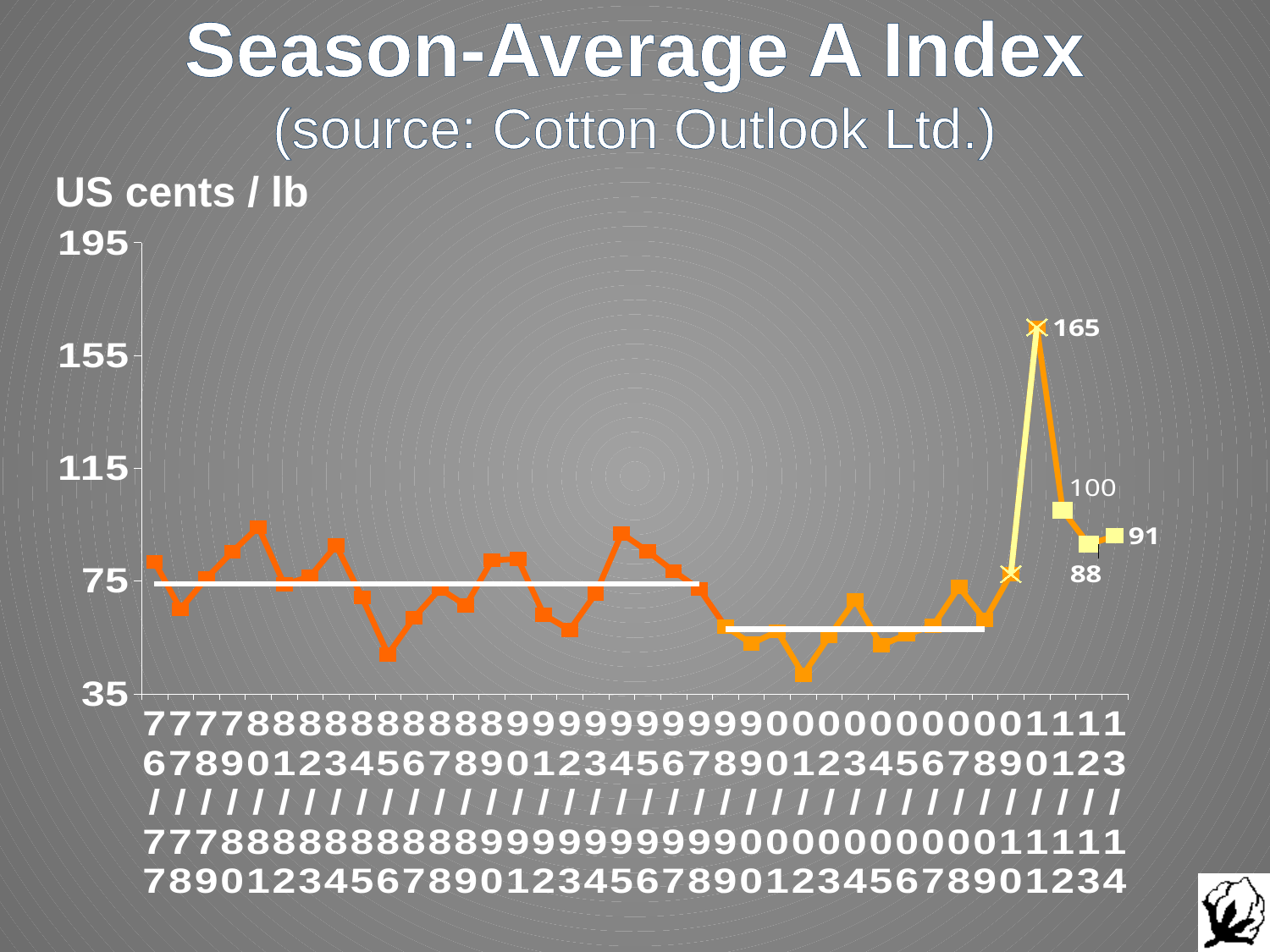
What kind of chart is shown on the slide? line chart Which season has the highest Season-Average A Index? 2010/11 Which season has the larger value, 2012/13 or 2013/14? 2013/14 What is the Season-Average A Index value for 2013/14? 91 What unit is the Season-Average A Index measured in on the chart? US cents / lb Is the value for 2010/11 greater or less than 155? greater Is the value for 2001/02 greater or less than 75? less What is the Season-Average A Index value for 2012/13? 88 What is the Season-Average A Index value for 2011/12? 100 What is the difference between the values for 2013/14 and 2012/13? 3 What is the Season-Average A Index value for 2010/11? 165 What is the difference between the values for 2010/11 and 2011/12? 65